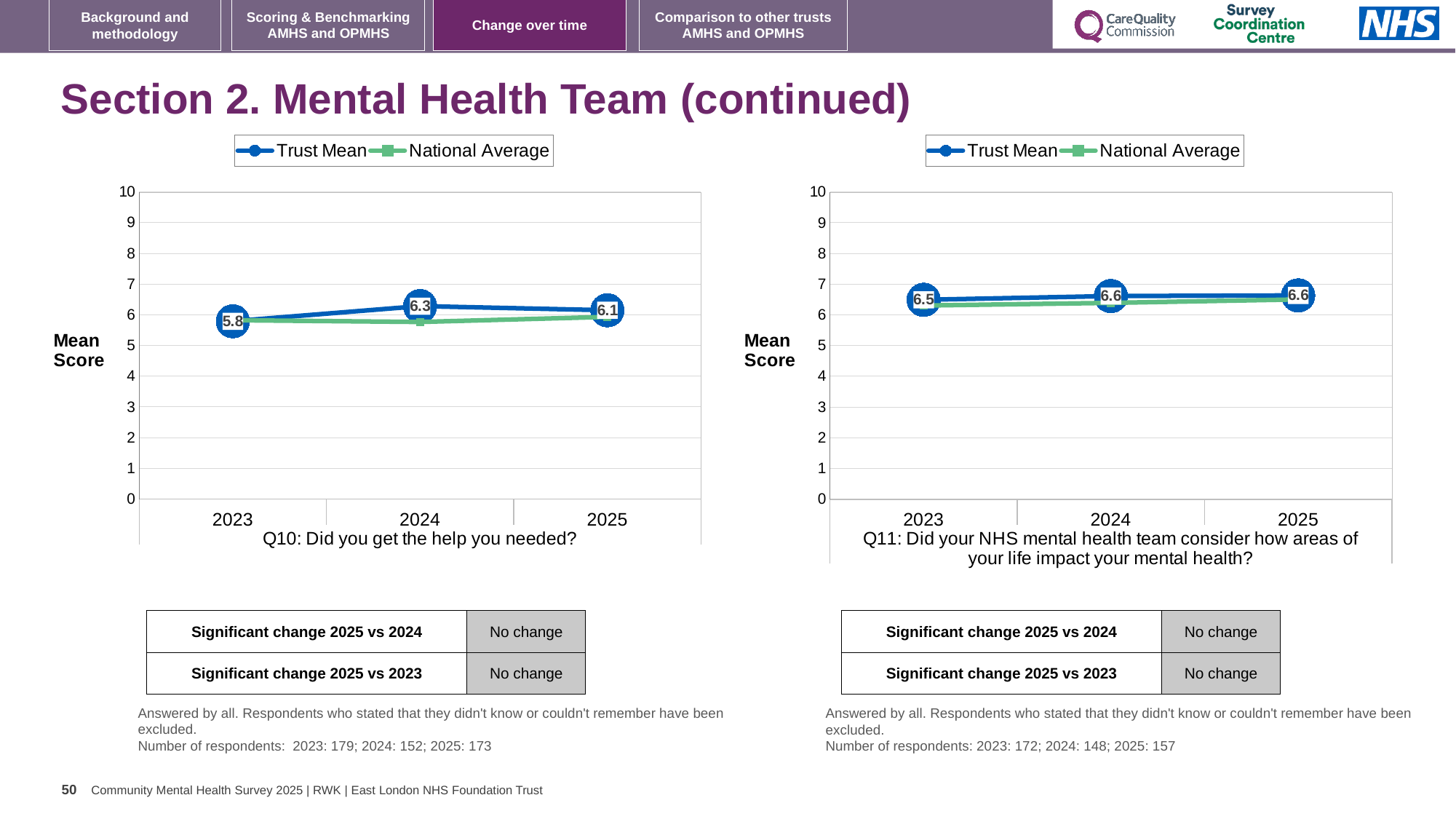
On the Q10 chart (left), what is the Trust Mean for 2023? 5.8 On the Q10 chart (left), which year has the lowest Trust Mean? 2023 What kind of chart is the Q11 chart (right)? Line chart On the Q11 chart (right), what is the Trust Mean for 2025? 6.6 On the Q10 chart (left), which year has the highest Trust Mean? 2024 On the Q11 chart (right), what is the Trust Mean for 2023? 6.5 On the Q10 chart (left), how many series does the legend list? 2 On the Q11 chart (right), is the Trust Mean for 2024 greater or less than 6? greater On the Q10 chart (left), what is the difference between the Trust Mean in 2024 and in 2023? 0.5 On the Q10 chart (left), what is the Trust Mean for 2024? 6.3 On the Q11 chart (right), how many years are shown on the x axis? 3 On the Q10 chart (left), what is the Trust Mean for 2025? 6.1